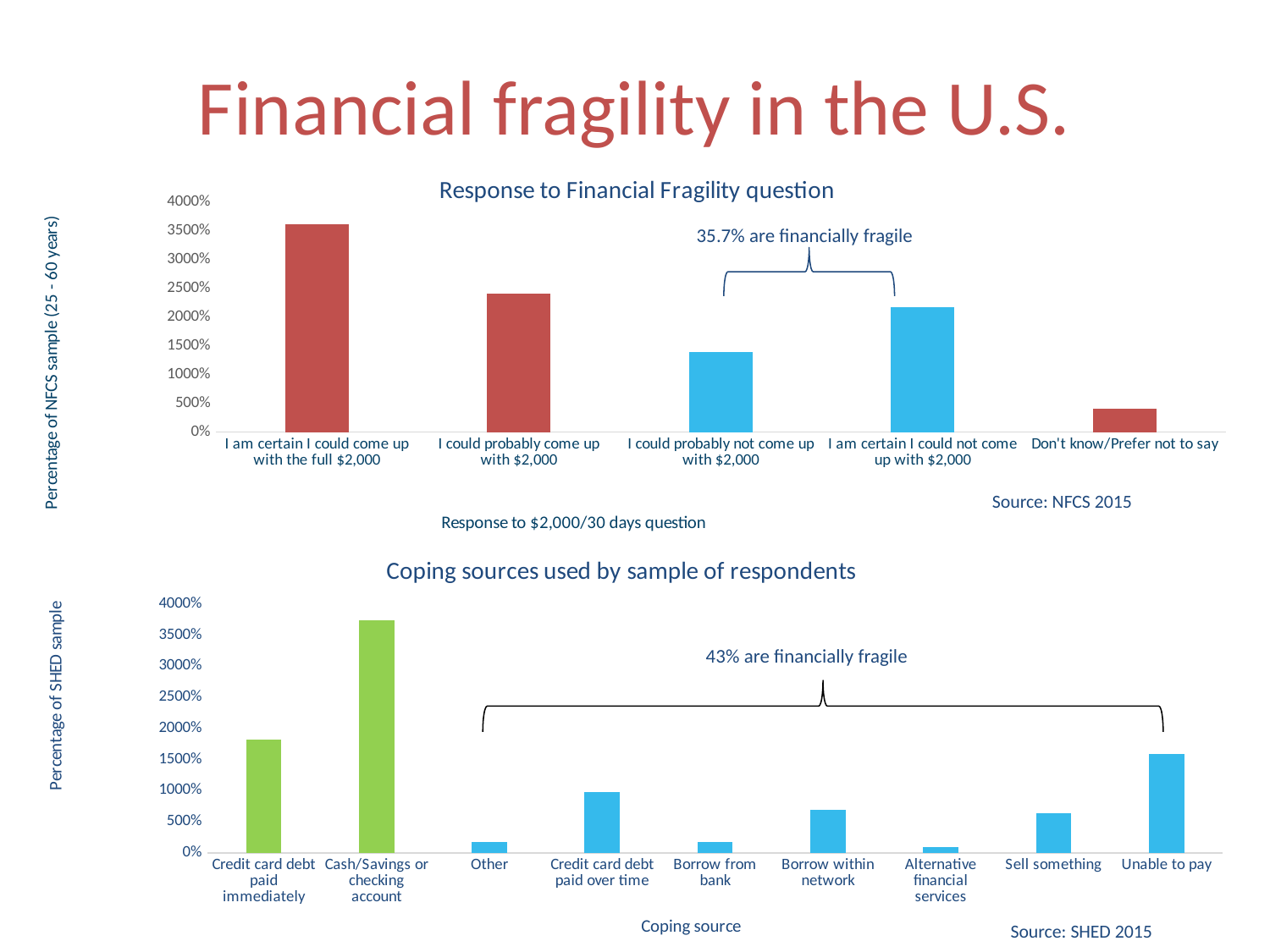
How many coping sources are shown in the 'Coping sources used by sample of respondents' chart? 9 According to the annotation on the 'Response to Financial Fragility question' chart, what percentage are financially fragile? 35.7% In the 'Coping sources used by sample of respondents' chart, which coping source has the highest value? Cash/Savings or checking account In the 'Response to Financial Fragility question' chart, is the value for 'I could probably come up with $2,000' greater or less than 2000%? greater In the 'Response to Financial Fragility question' chart, which is larger: 'I could probably come up with $2,000' or 'I am certain I could not come up with $2,000'? I could probably come up with $2,000 In the 'Coping sources used by sample of respondents' chart, is the value for 'Credit card debt paid immediately' greater or less than 2000%? less In the 'Response to Financial Fragility question' chart, which response category has the lowest value? Don't know/Prefer not to say How many response categories are shown in the 'Response to Financial Fragility question' chart? 5 What type of chart is the 'Response to Financial Fragility question' chart? bar chart In the 'Response to Financial Fragility question' chart, which response category has the highest value? I am certain I could come up with the full $2,000 In the 'Coping sources used by sample of respondents' chart, which coping source has the lowest value? Alternative financial services In the 'Coping sources used by sample of respondents' chart, which is larger: 'Credit card debt paid immediately' or 'Unable to pay'? Credit card debt paid immediately